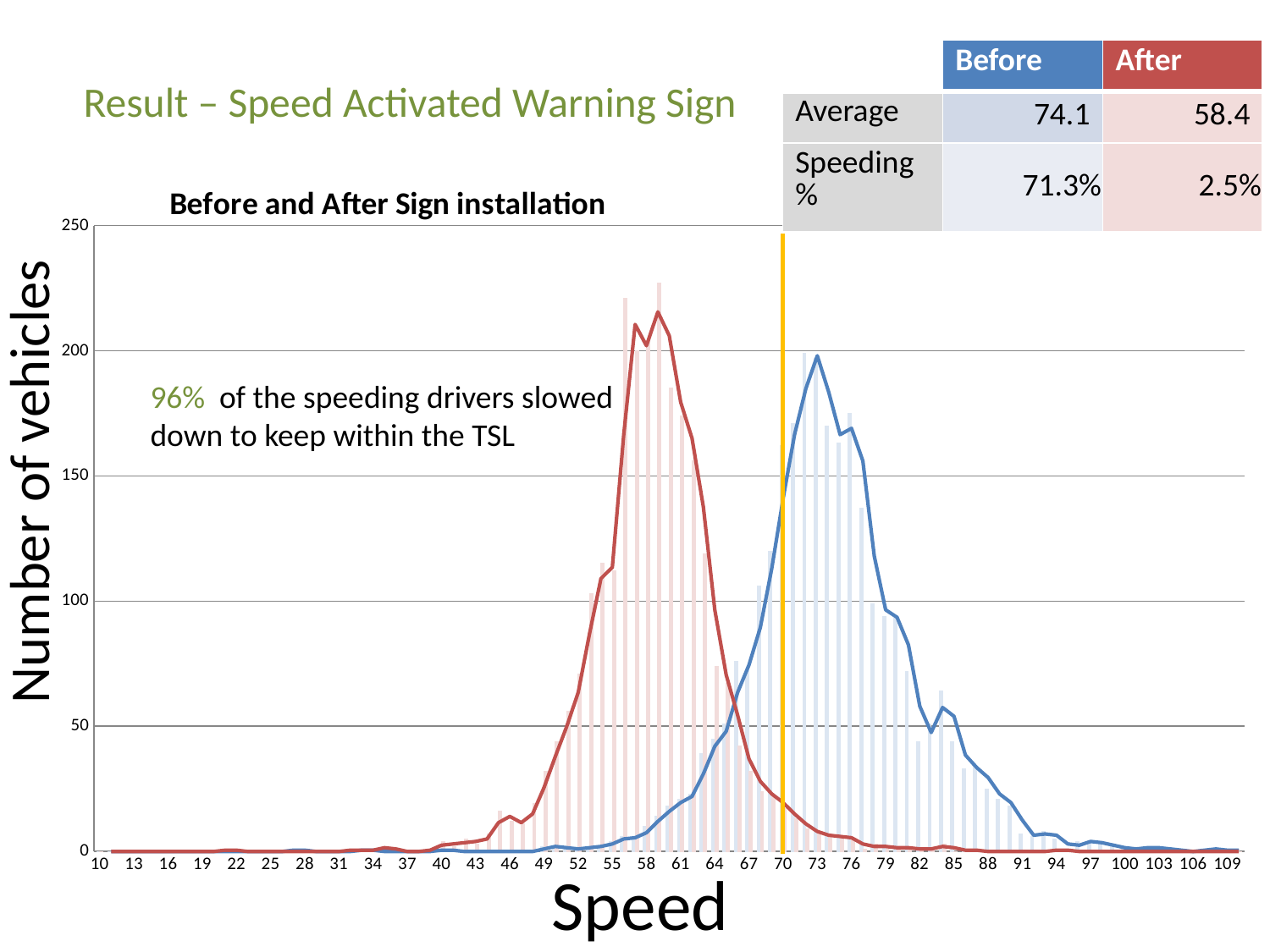
What is the title of the chart on the slide? Before and After Sign installation At speed 76, which series has the larger value, the red or the blue? blue Is the value of the blue series at speed 91 greater or less than 50? less Is the value of the red series at speed 70 greater or less than 50? less Do the values of the blue series rise or fall as speed increases from 73 to 100? fall At speed 58, which series has the larger value, the red or the blue? red Is the value of the blue series at speed 58 greater or less than 50? less What is the label on the horizontal axis of the chart? Speed Which series reaches its peak at a higher speed, the red or the blue? blue What is the label on the vertical axis of the chart? Number of vehicles